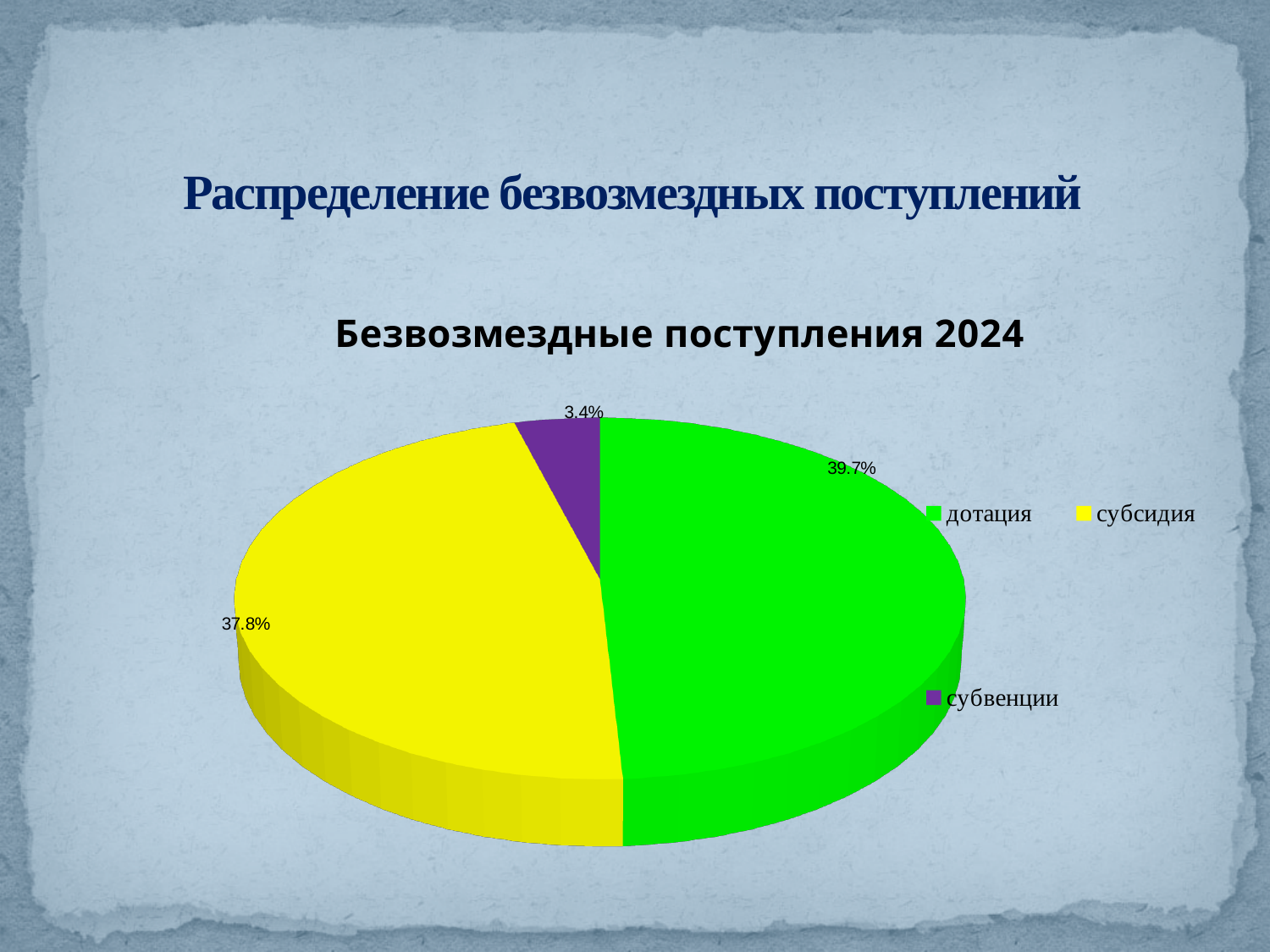
What percentage is shown for субсидия? 37.8% What percentage is shown for дотация? 39.7% Which is larger, the share for дотация or the share for субвенции? дотация How many entries does the legend list? 3 What is the difference in percentage points between дотация and субсидия? 1.9 What percentage is shown for субвенции? 3.4% What kind of chart is shown on the slide? Pie chart What colour is the slice for субвенции? Purple Which category has the smallest slice of the pie? субвенции How many slices does the pie chart have? 3 Which category has the largest slice of the pie? дотация What is the title of the chart? Безвозмездные поступления 2024